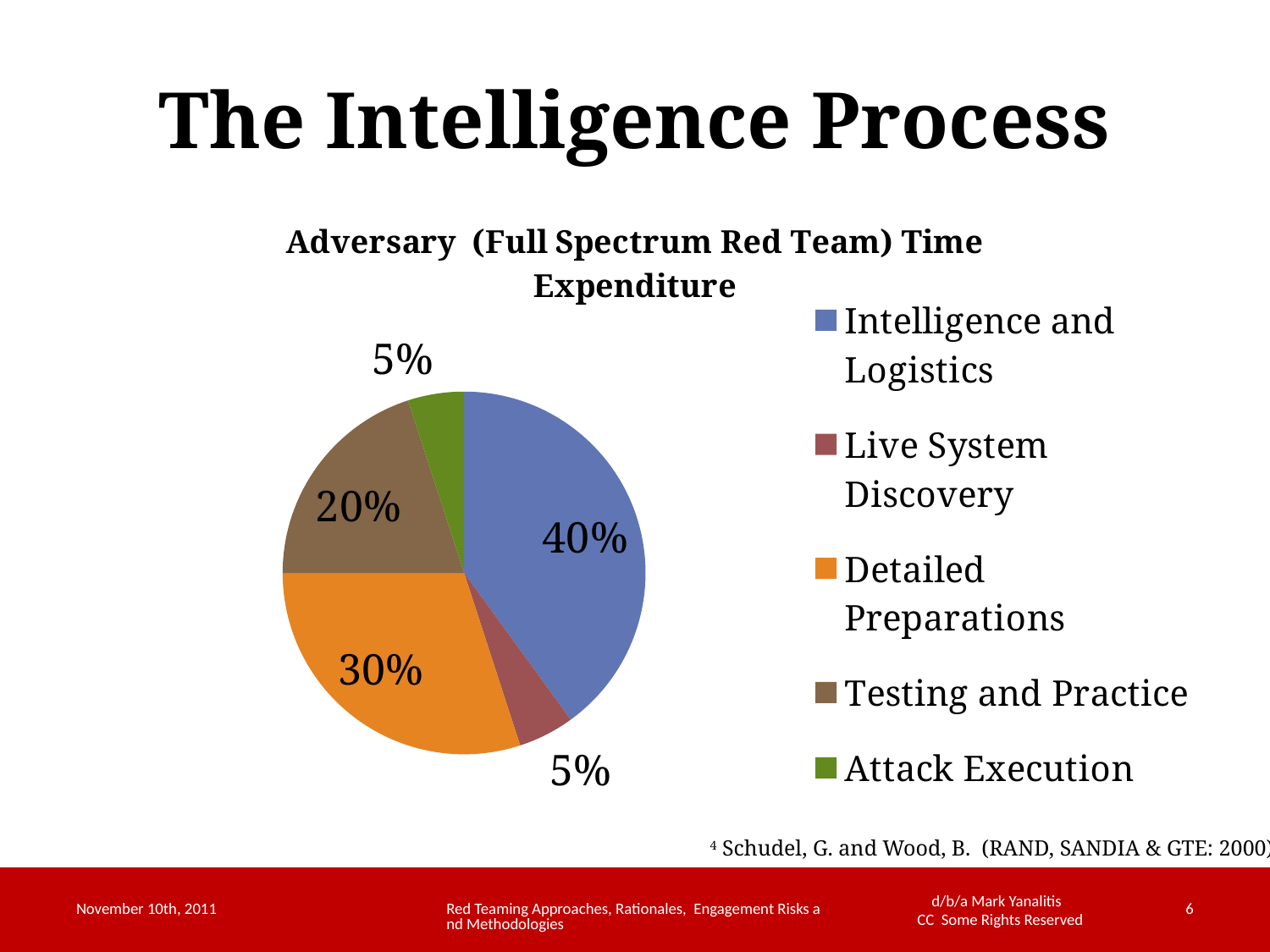
What percentage is shown for Testing and Practice? 20% How many categories are shown in the pie chart? 5 What type of chart is shown on the slide? Pie chart What is the title of the chart? Adversary (Full Spectrum Red Team) Time Expenditure What percentage is shown for Detailed Preparations? 30% What colour represents Attack Execution in the pie chart? Green What percentage is shown for Attack Execution? 5% Which is larger, Testing and Practice or Detailed Preparations? Detailed Preparations What percentage is shown for Live System Discovery? 5% Which category takes the largest share of the pie chart? Intelligence and Logistics What share of time does Intelligence and Logistics take in the Adversary (Full Spectrum Red Team) Time Expenditure pie chart? 40% What is the difference in percentage points between Intelligence and Logistics and Detailed Preparations? 10%